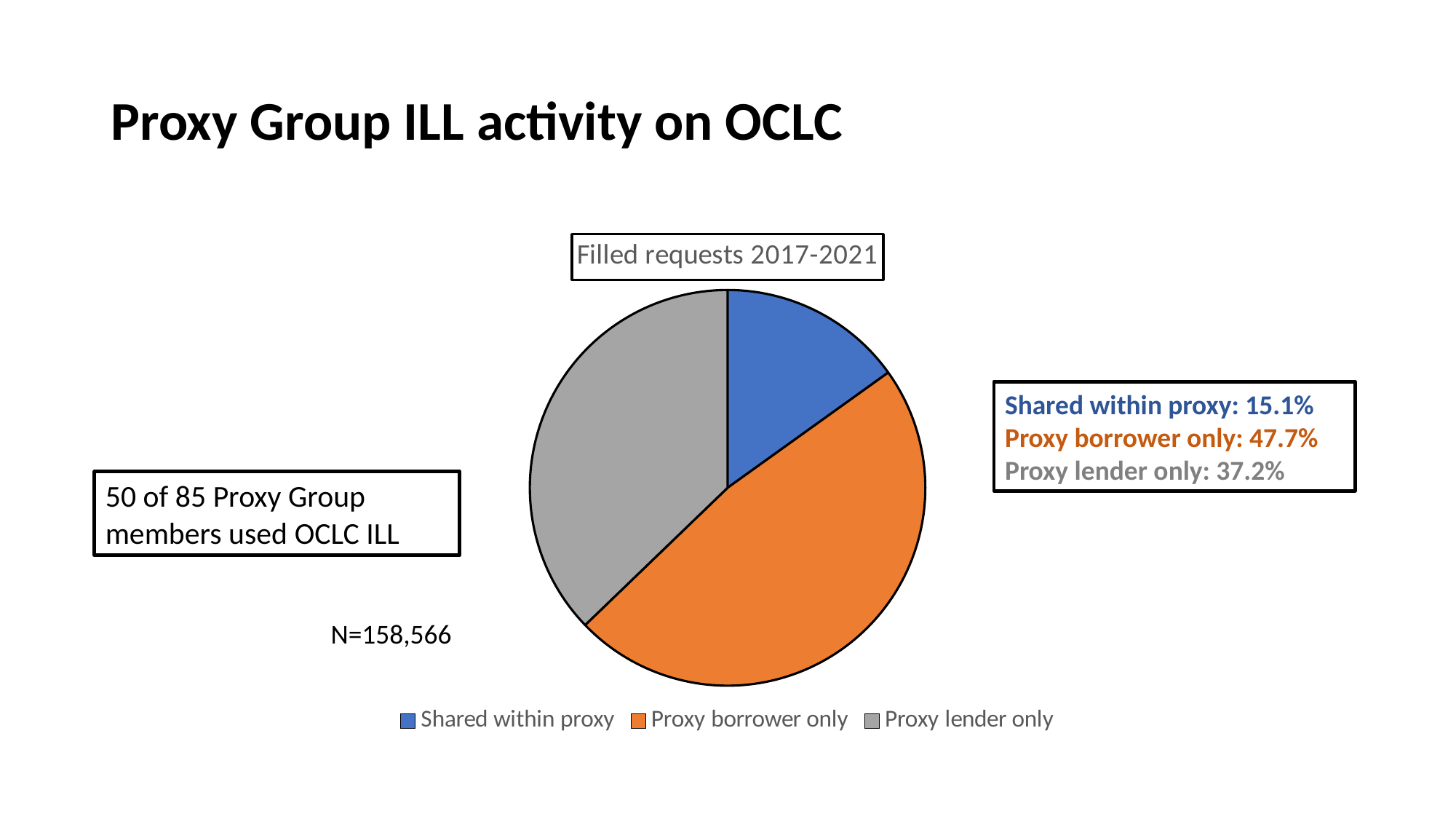
What colour is the 'Proxy lender only' slice? grey What is the difference in percentage points between 'Proxy borrower only' and 'Proxy lender only'? 10.5 What share of filled requests is 'Shared within proxy'? 15.1% Which category has the smallest share of the pie? Shared within proxy What is the title of the chart? Filled requests 2017-2021 Which category has the largest share of the pie? Proxy borrower only What share of filled requests is 'Proxy borrower only'? 47.7% How many entries does the legend list? 3 What kind of chart is shown on the slide? pie chart Which is larger, the share for 'Proxy lender only' or 'Shared within proxy'? Proxy lender only What share of filled requests is 'Proxy lender only'? 37.2% How many slices does the pie chart have? 3